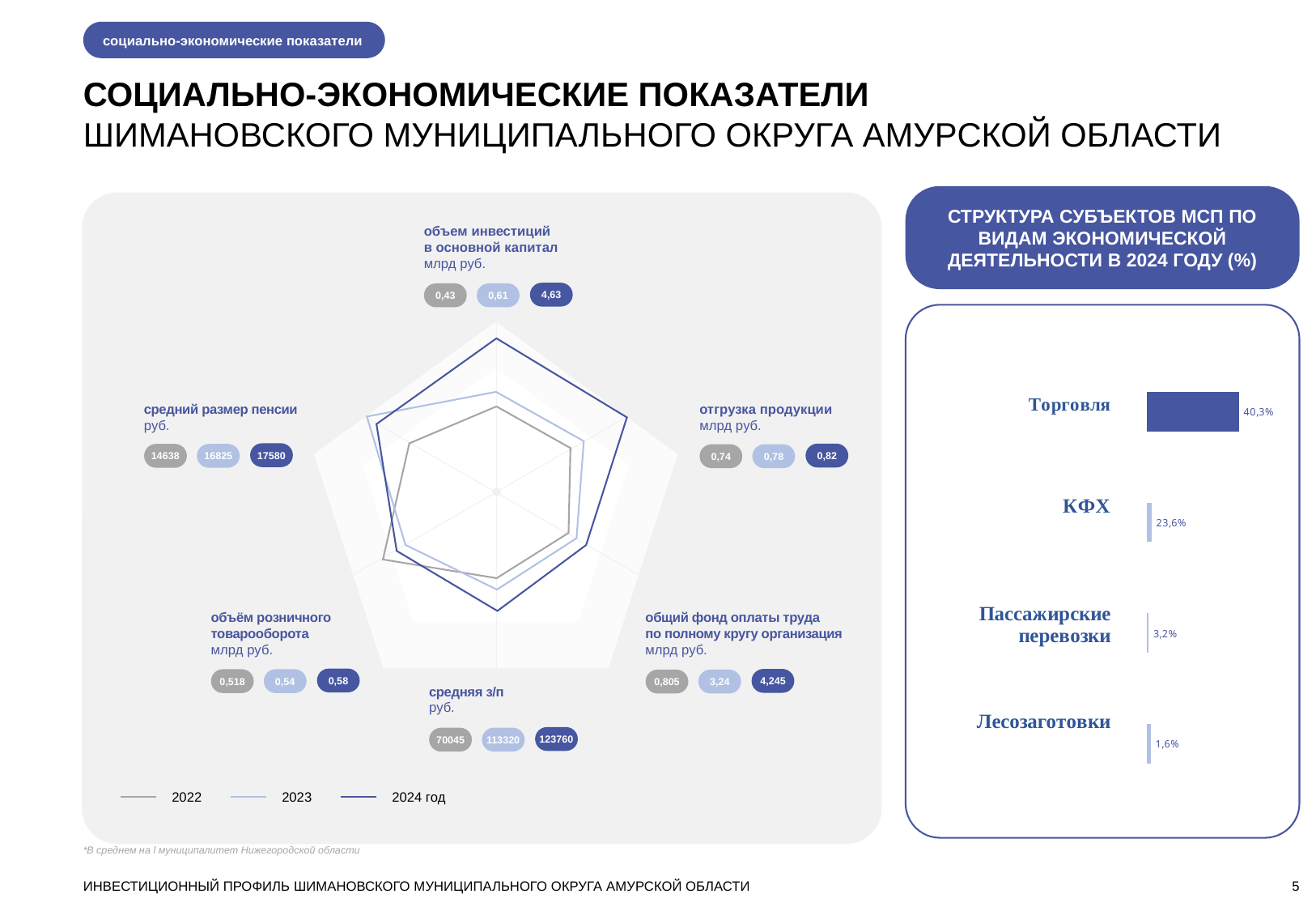
In the radar chart on the left, which year has the larger value for 'отгрузка продукции': 2022 or 2024? 2024 In the radar chart on the left, does 'средний размер пенсии' rise or fall from 2022 to 2024? rise In the bar chart on the right, which category has the highest value? Торговля In the radar chart on the left, what is the value of 'средняя з/п' for 2023? 113320 How many indicators (axes) does the radar chart on the left have? 6 In the bar chart on the right, which category has the lowest value? Лесозаготовки In the radar chart on the left, what is the value of 'объем инвестиций в основной капитал' for 2024? 4,63 How many categories are shown in the bar chart on the right? 4 In the bar chart on the right, what is the difference between the values for Торговля and КФХ? 16,7% What kind of chart is shown on the right side of the slide? bar chart In the bar chart 'Структура субъектов МСП по видам экономической деятельности в 2024 году (%)', what is the value for Торговля? 40,3% How many series (years) does the legend of the radar chart on the left list? 3